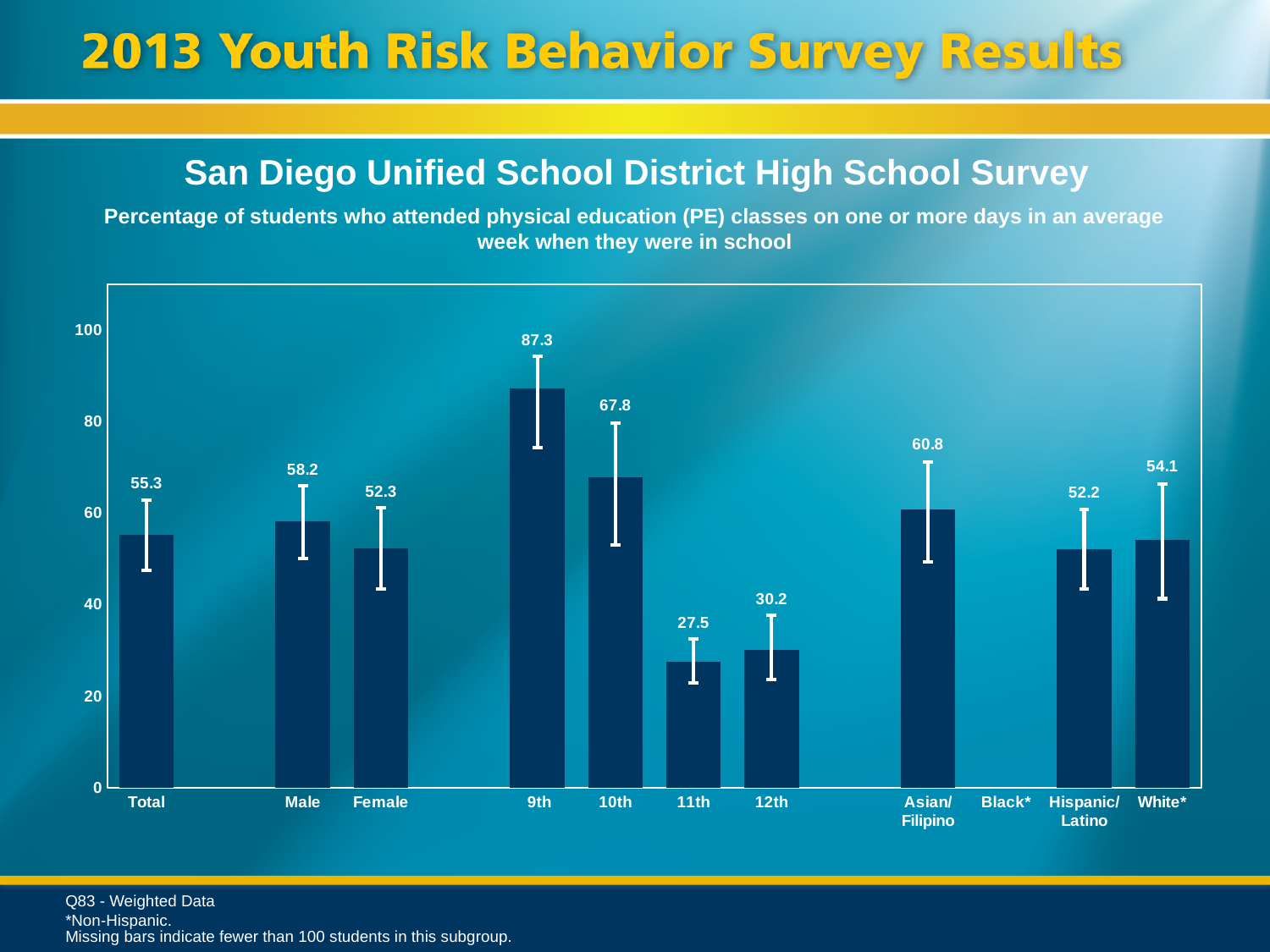
Is the value for 12th grade greater or less than 40? less Which is larger, the value for White* or the value for Hispanic/Latino? White* What is the difference between the values for Male and Female? 5.9 What is the value for Total? 55.3 Which category label has no bar plotted? Black* Which category has the highest value? 9th Which category has the lowest value among the plotted bars? 11th What is the difference between the values for 9th and 10th grade? 19.5 What is the value for 9th grade students? 87.3 What is the value for Asian/Filipino students? 60.8 What kind of chart is shown? bar chart How many bars are plotted on the chart? 10